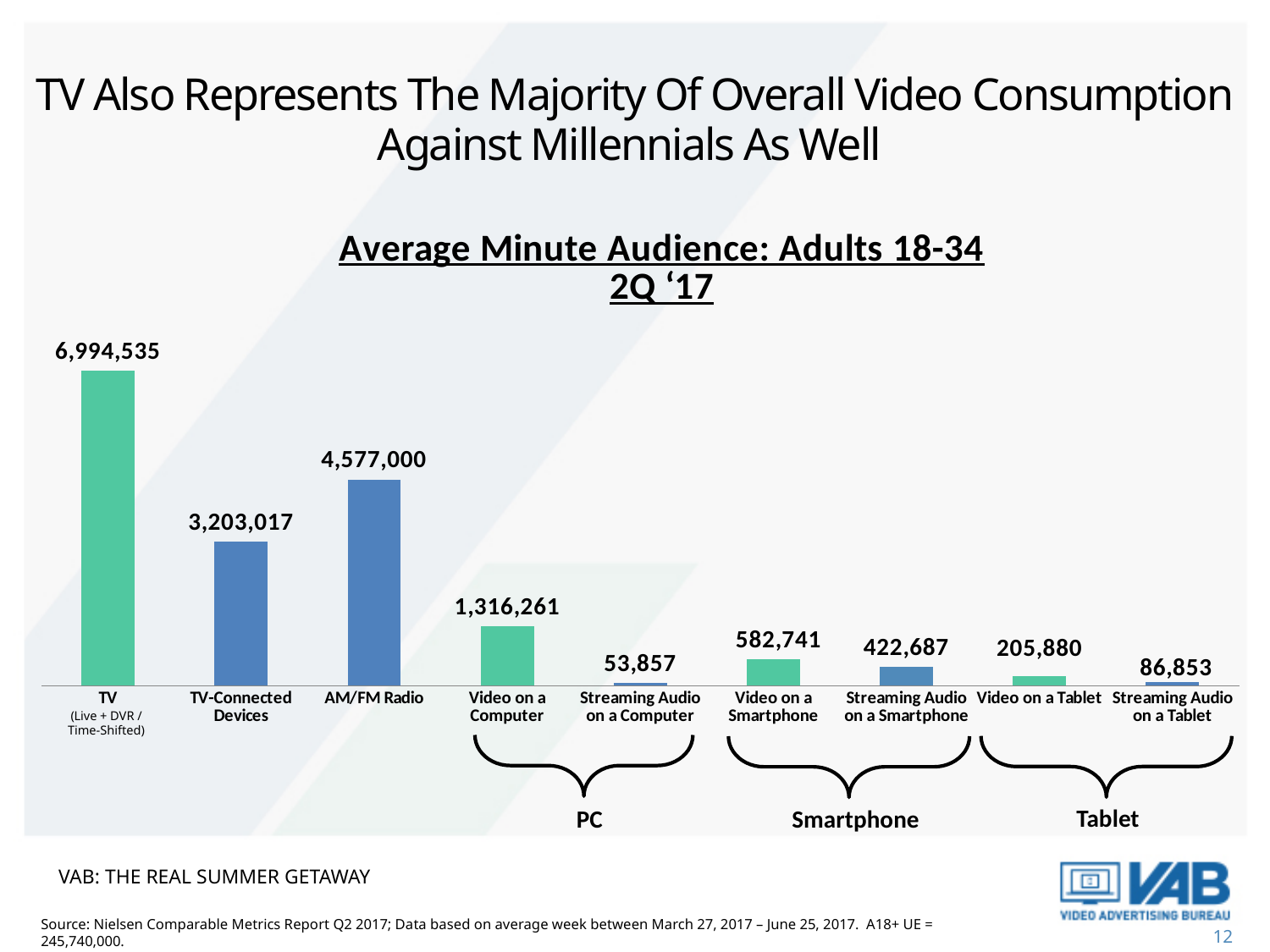
Which is larger: Video on a Computer or Video on a Smartphone? Video on a Computer What is the value for AM/FM Radio? 4,577,000 What is the value for Streaming Audio on a Computer? 53,857 How many categories are shown in the chart? 9 What is the difference between the values for TV and TV-Connected Devices? 3,791,518 Which category has the lowest average minute audience? Streaming Audio on a Computer What is the average minute audience for TV (Live + DVR / Time-Shifted)? 6,994,535 Which category has the highest average minute audience? TV What kind of chart is shown on the slide? Bar chart What is the value for Video on a Tablet? 205,880 What is the title of the chart? Average Minute Audience: Adults 18-34 2Q '17 What is the difference between Video on a Smartphone and Streaming Audio on a Smartphone? 160,054